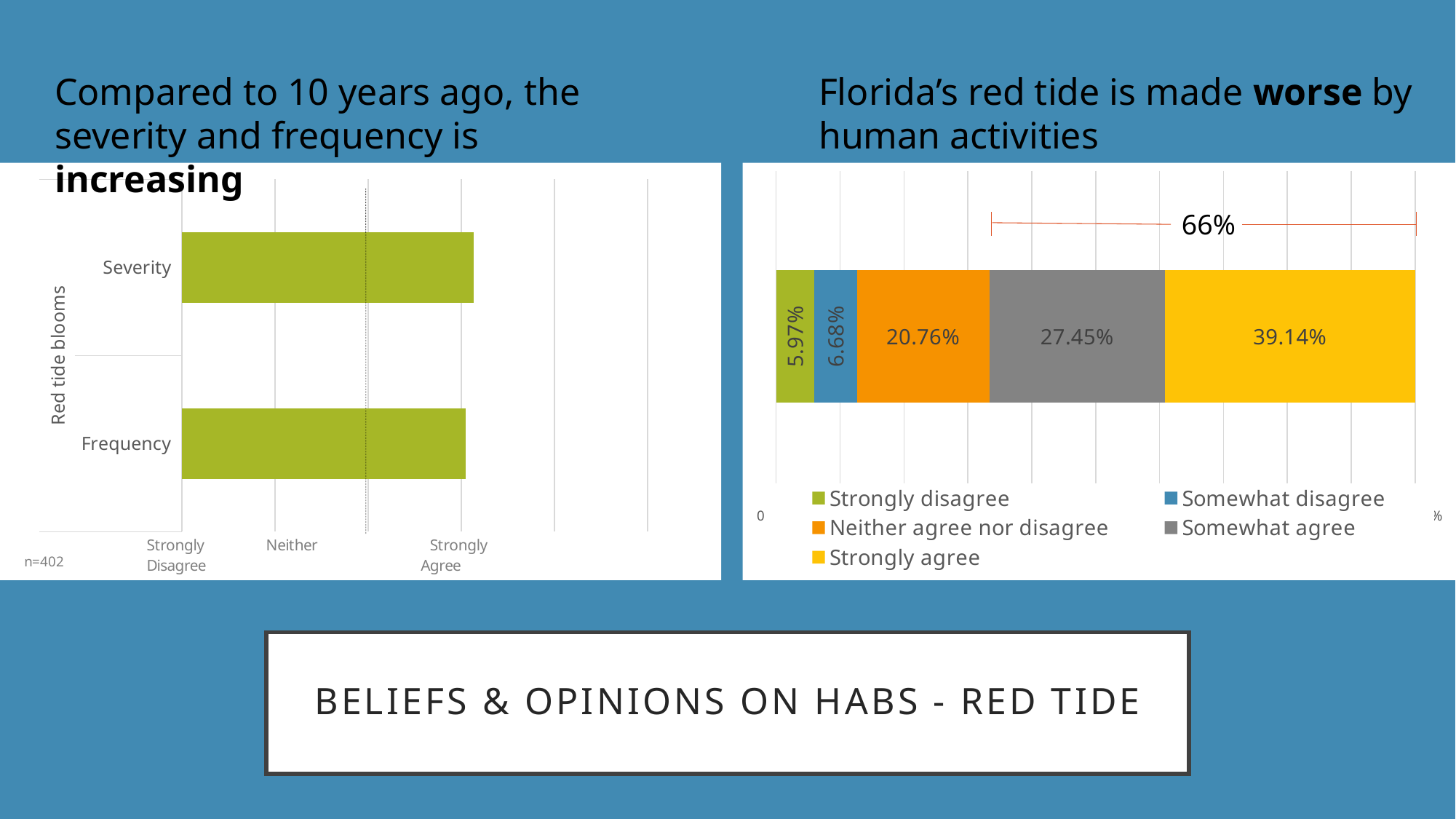
In the left chart ("Compared to 10 years ago, the severity and frequency is increasing"), what kind of chart is shown? Bar chart In the right chart, which response category has the smallest share? Strongly disagree In the right chart, what percentage of respondents neither agree nor disagree? 20.76% In the right chart ("Florida's red tide is made worse by human activities"), what percentage of respondents strongly agree? 39.14% In the right chart, what percentage of respondents somewhat disagree? 6.68% In the right chart, which is larger: Neither agree nor disagree or Somewhat disagree? Neither agree nor disagree In the left chart, what is the label of the vertical axis? Red tide blooms In the right chart, how many response categories does the legend list? 5 In the left chart, how many categories are plotted on the vertical axis? 2 In the right chart, what percentage does the bracket annotation above the bar show? 66% In the right chart, which response category has the largest share? Strongly agree In the right chart, what is the difference between the Strongly agree and Somewhat agree percentages? 11.69%